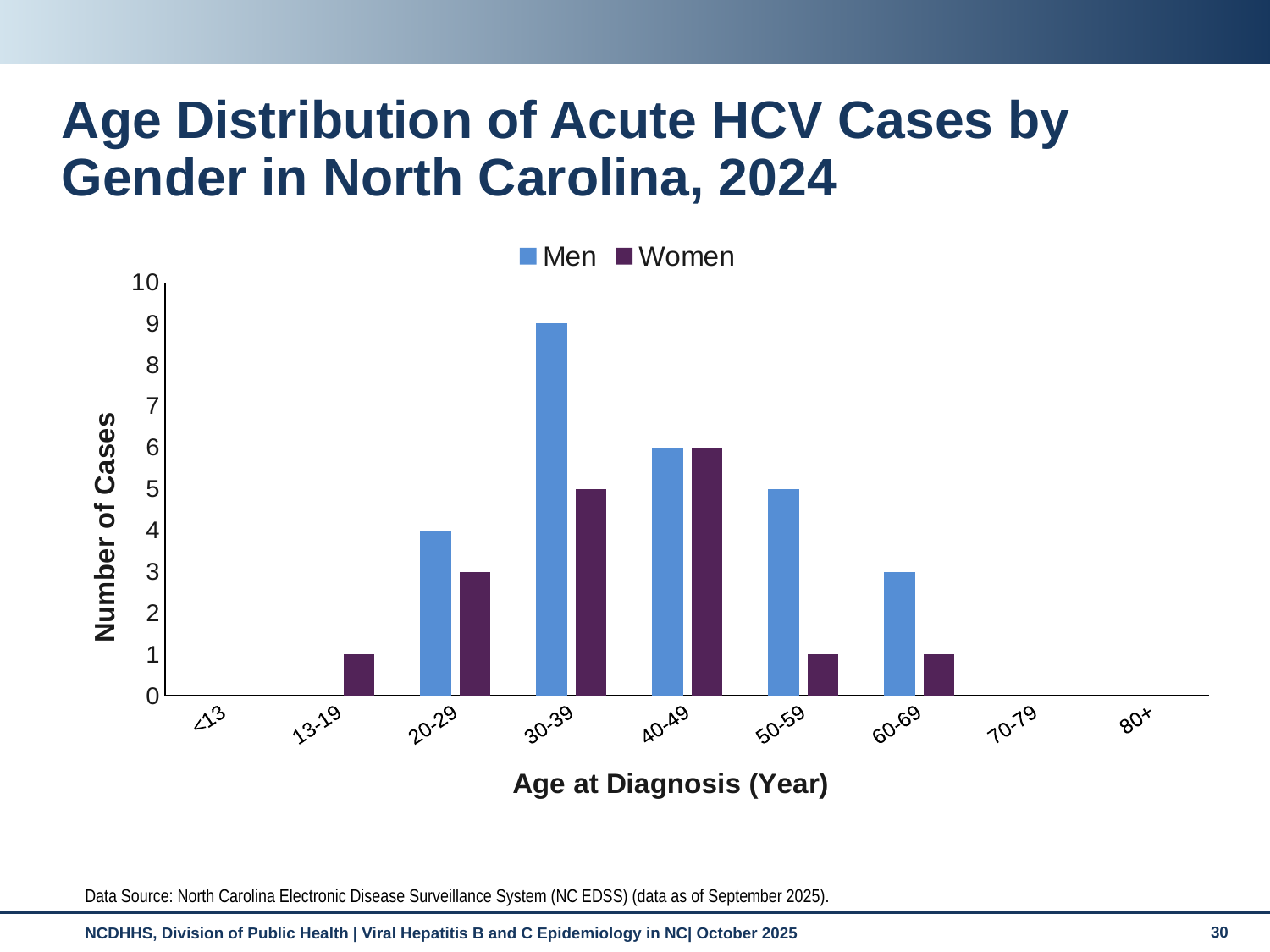
What is the label of the y axis? Number of Cases What is the number of cases for Women in the 13-19 age group? 1 What is the difference between Men and Women cases in the 30-39 age group? 4 What kind of chart is shown on the slide? bar chart Is the value for Men in the 40-49 age group greater or less than 5? greater What is the number of cases for Men in the 30-39 age group? 9 Which age group has the highest number of cases for Men? 30-39 How many series does the legend list? 2 Which is larger in the 50-59 age group, the value for Men or for Women? Men How many age categories are shown on the x axis? 9 Which age group has the highest number of cases for Women? 40-49 What is the number of cases for Women in the 20-29 age group? 3